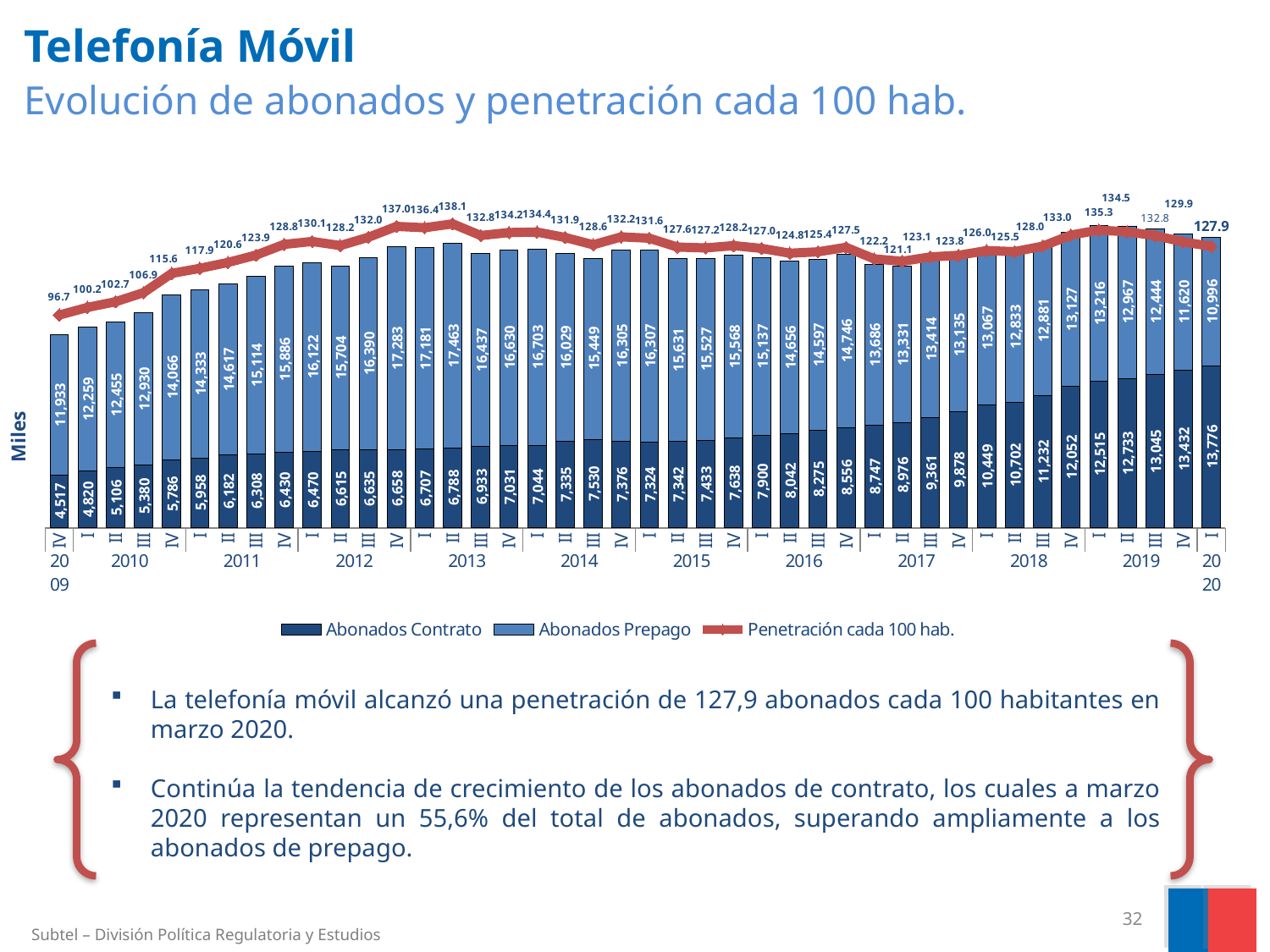
What is the lowest Abonados Contrato value shown on the chart? 4,517 What is the Penetración cada 100 hab. value for the fourth quarter (IV) of 2009? 96.7 Does the Abonados Contrato series rise or fall from IV 2009 to I 2020? Rise What is the value of Abonados Contrato in the first quarter (I) of 2020? 13,776 What is the difference between Abonados Contrato and Abonados Prepago in the first quarter (I) of 2020? 2,780 What is the label of the vertical axis? Miles In which quarter does Penetración cada 100 hab. reach its highest value, and what is that value? II 2013, 138.1 What kind of chart is shown on the slide? Combined stacked bar and line chart What is the value of Abonados Prepago in the first quarter (I) of 2020? 10,996 In the fourth quarter (IV) of 2012, which is larger: Abonados Contrato or Abonados Prepago? Abonados Prepago What is the total of the stacked bar (Abonados Contrato plus Abonados Prepago) for the first quarter (I) of 2020? 24,772 How many series does the legend list? 3